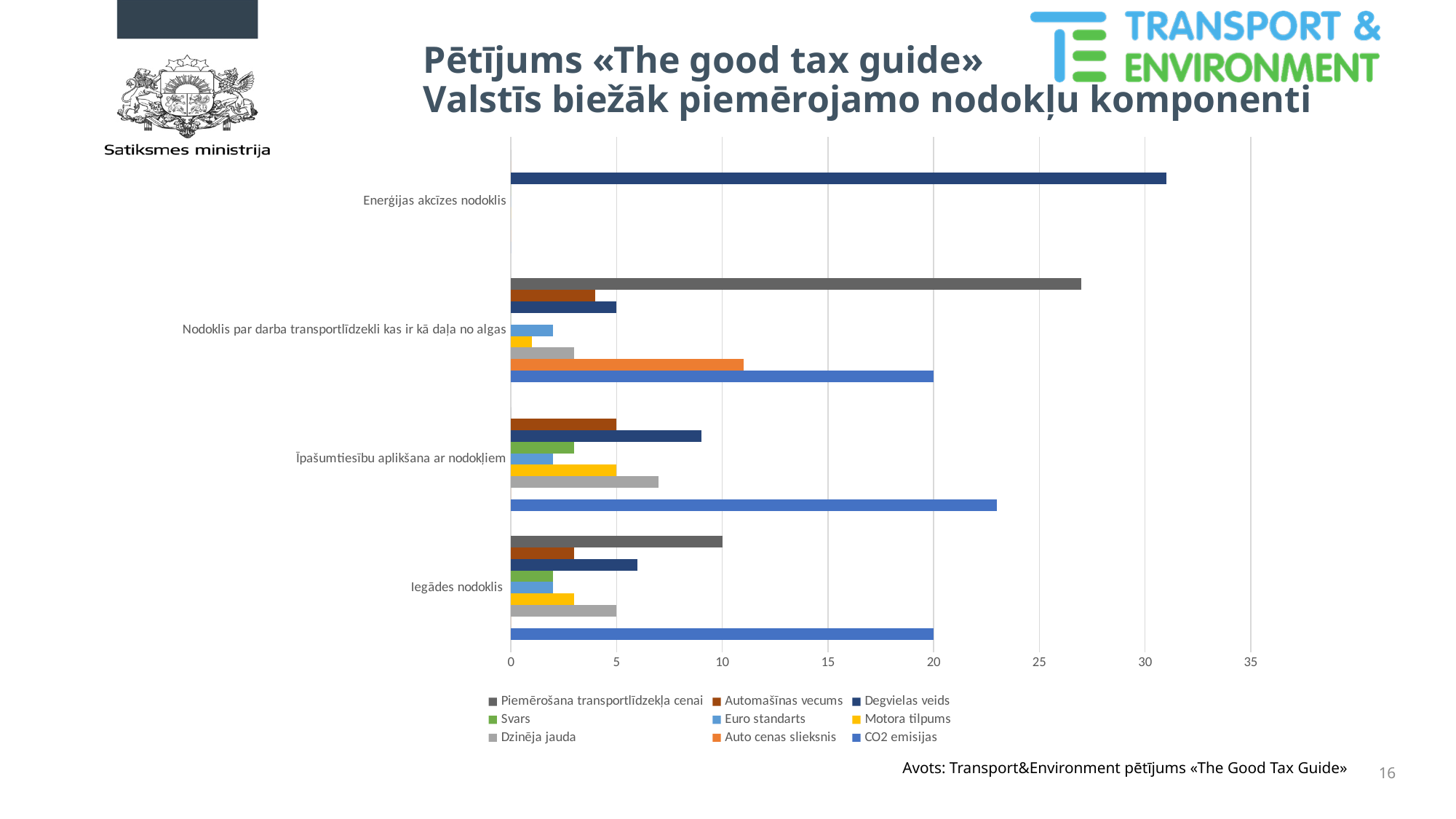
How many series does the chart legend list? 9 What kind of chart is shown on the slide? bar chart Which series has the longest bar for Īpašumtiesību aplikšana ar nodokļiem? CO2 emisijas For Iegādes nodoklis, which is larger: CO2 emisijas or Piemērošana transportlīdzekļa cenai? CO2 emisijas Is the value of Degvielas veids for Īpašumtiesību aplikšana ar nodokļiem greater or less than 10? less Which series has the longest bar for Enerģijas akcīzes nodoklis? Degvielas veids How many categories are shown on the vertical axis of the chart? 4 Is the value of Degvielas veids for Enerģijas akcīzes nodoklis greater or less than 30? greater Is the value of CO2 emisijas for Īpašumtiesību aplikšana ar nodokļiem greater or less than 20? greater What is the source cited below the chart? Transport&Environment pētījums «The Good Tax Guide»